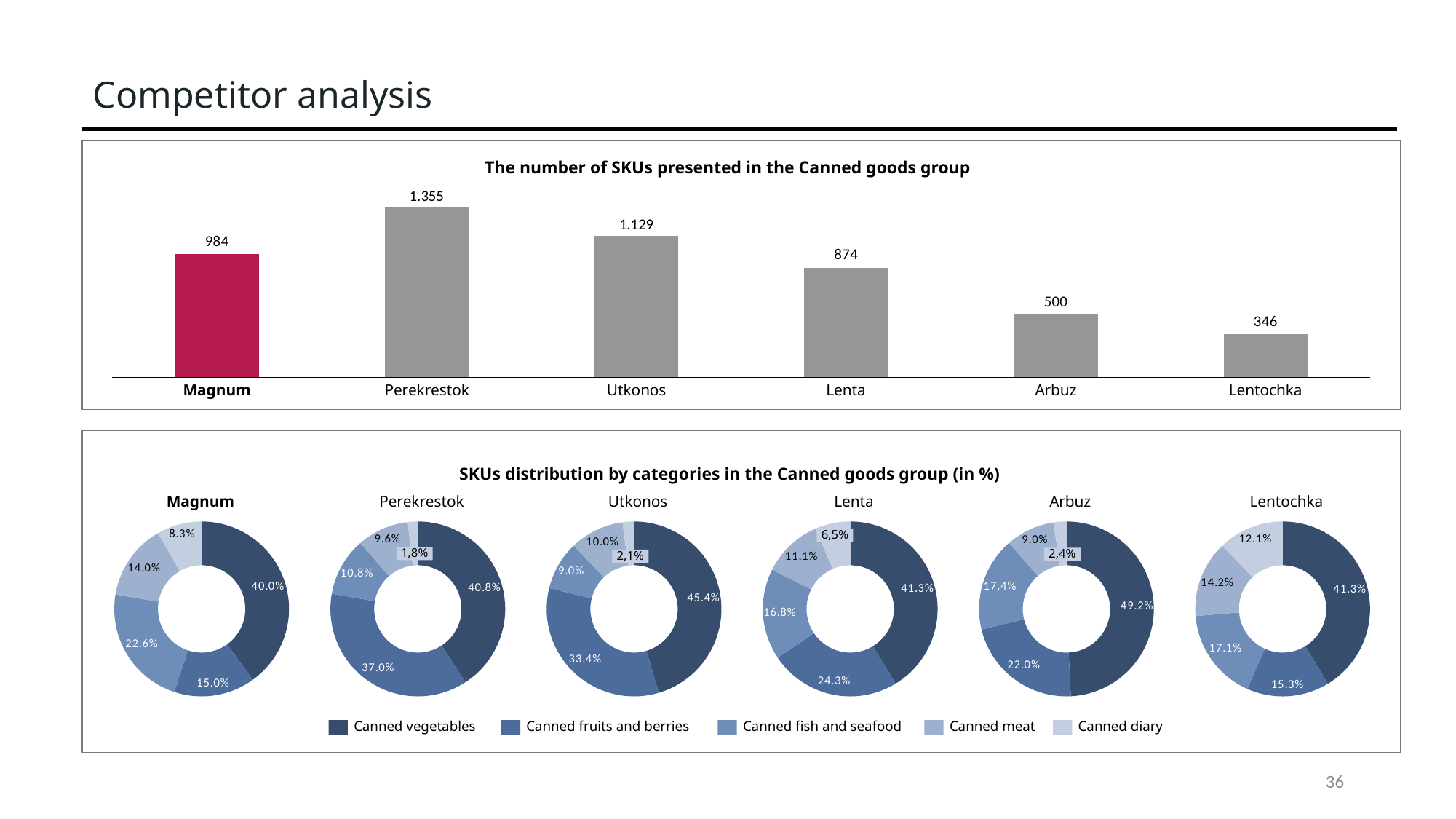
In the chart 'The number of SKUs presented in the Canned goods group', which has more SKUs, Utkonos or Lenta? Utkonos In the chart 'The number of SKUs presented in the Canned goods group', which bar is highlighted in a different colour from the others? Magnum In the chart 'The number of SKUs presented in the Canned goods group', how many retailers are shown? 6 In the chart 'SKUs distribution by categories in the Canned goods group (in %)', what share of Magnum's SKUs is Canned vegetables? 40.0% What kind of chart is 'The number of SKUs presented in the Canned goods group'? Bar chart In the chart 'The number of SKUs presented in the Canned goods group', how many SKUs does Magnum have? 984 In the chart 'SKUs distribution by categories in the Canned goods group (in %)', how many categories does the legend list? 5 In the chart 'The number of SKUs presented in the Canned goods group', which retailer has the highest number of SKUs? Perekrestok In the chart 'SKUs distribution by categories in the Canned goods group (in %)', what share of Perekrestok's SKUs is Canned fruits and berries? 37.0% In the chart 'The number of SKUs presented in the Canned goods group', which retailer has the lowest number of SKUs? Lentochka In the chart 'SKUs distribution by categories in the Canned goods group (in %)', what share of Arbuz's SKUs is Canned vegetables? 49.2% In the chart 'The number of SKUs presented in the Canned goods group', what is the difference between Perekrestok's and Magnum's number of SKUs? 371